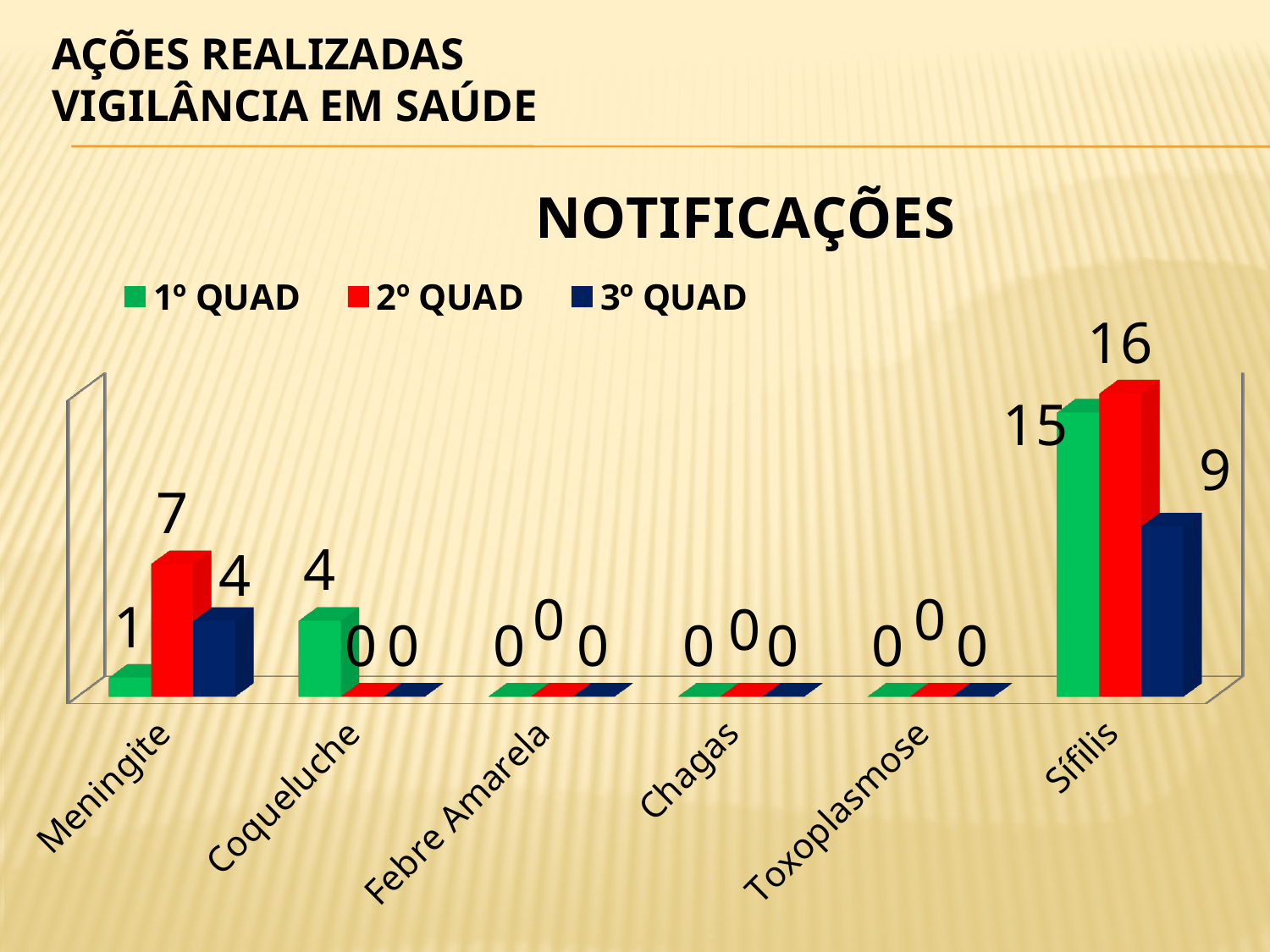
What is the value for Meningite in the 2º QUAD series? 7 Which is larger for Meningite: the 1º QUAD value or the 3º QUAD value? 3º QUAD What is the title of the chart? NOTIFICAÇÕES How many series does the legend list? 3 How many categories are shown on the x axis? 6 What is the difference between the 2º QUAD and 1º QUAD values for Sífilis? 1 What is the difference between the 2º QUAD and 3º QUAD values for Meningite? 3 Which category has the highest value in the 2º QUAD series? Sífilis What kind of chart is shown? bar chart What is the total of the three series values for Sífilis? 40 What is the value for Coqueluche in the 1º QUAD series? 4 What is the value for Sífilis in the 3º QUAD series? 9